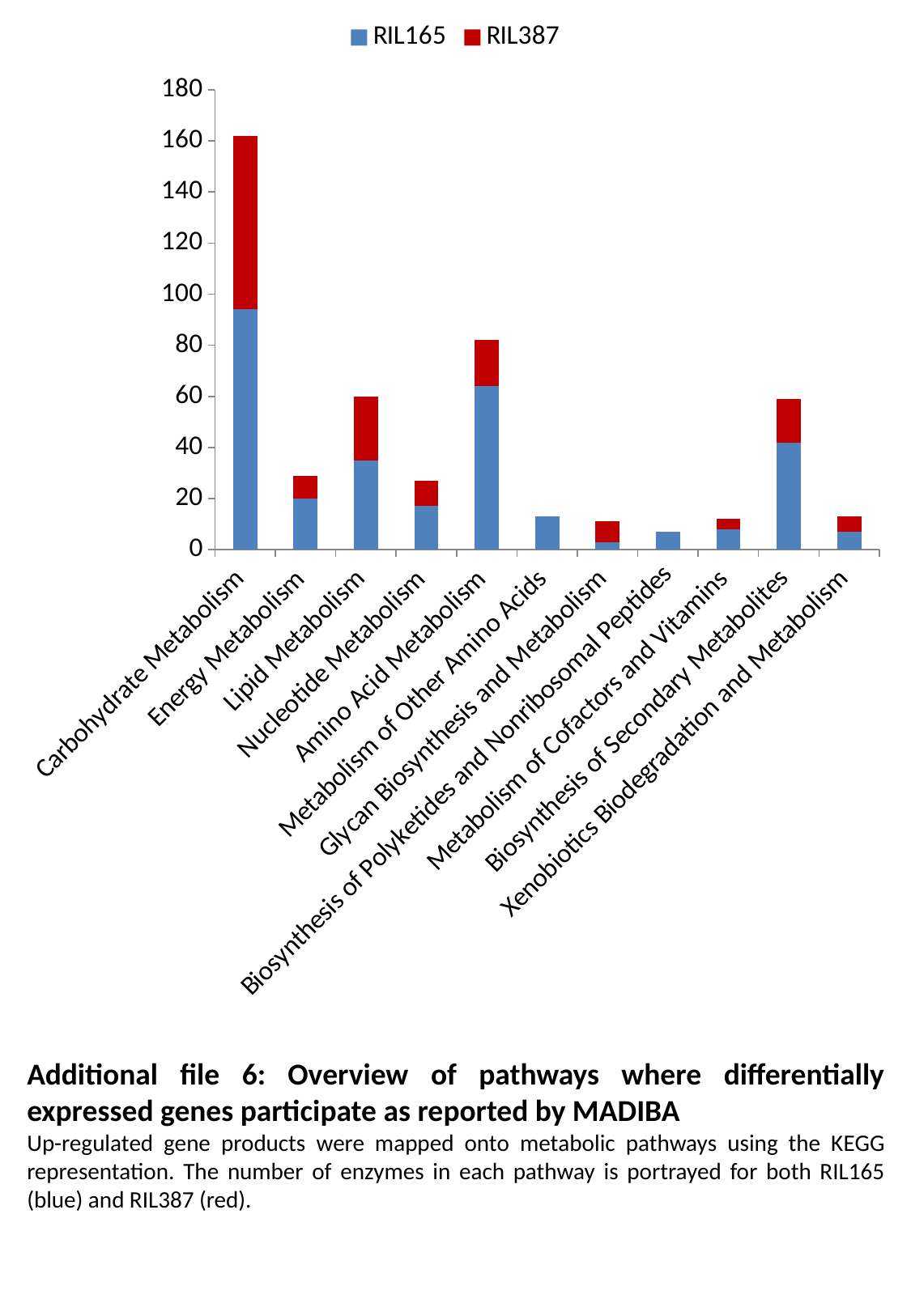
How many series does the legend list? 2 Which pathway has the highest total bar? Carbohydrate Metabolism Is the total bar for Energy Metabolism greater or less than 40? less Which has the larger total bar, Carbohydrate Metabolism or Amino Acid Metabolism? Carbohydrate Metabolism Is the total bar for Carbohydrate Metabolism greater or less than 140? greater What kind of chart is shown on the slide? Stacked bar chart Which has the larger total bar, Lipid Metabolism or Energy Metabolism? Lipid Metabolism Which pathway has the lowest total bar? Biosynthesis of Polyketides and Nonribosomal Peptides Which series is shown in red in the legend? RIL387 How many pathway categories are shown on the x axis? 11 Is the total bar for Biosynthesis of Secondary Metabolites greater or less than 40? greater